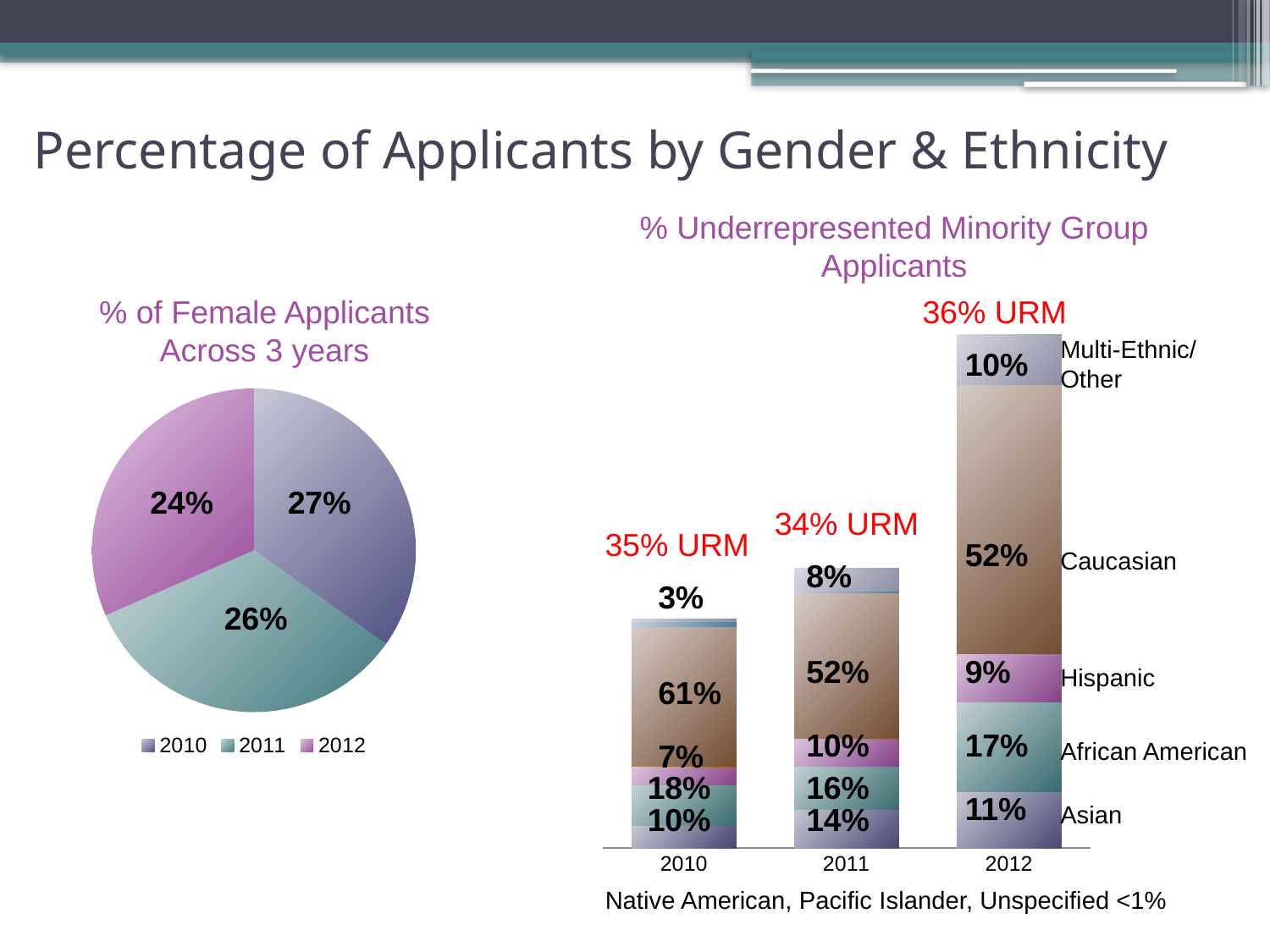
In the '% Underrepresented Minority Group Applicants' chart, what is the Asian percentage for 2011? 14% What kind of chart is the '% Underrepresented Minority Group Applicants' chart? stacked bar chart In the '% Underrepresented Minority Group Applicants' chart, what is the Caucasian percentage for 2010? 61% In the '% Underrepresented Minority Group Applicants' chart, how many years are shown on the x axis? 3 In the '% of Female Applicants Across 3 years' pie chart, which year has the smallest slice? 2012 In the '% Underrepresented Minority Group Applicants' chart, what is the Multi-Ethnic/Other percentage for 2012? 10% In the '% of Female Applicants Across 3 years' pie chart, what is the value for 2010? 27% What kind of chart is the '% of Female Applicants Across 3 years' chart? pie chart In the '% Underrepresented Minority Group Applicants' chart, which year has the highest African American percentage? 2010 In the '% Underrepresented Minority Group Applicants' chart, which is larger: the Hispanic percentage for 2011 or for 2012? 2011 In the '% Underrepresented Minority Group Applicants' chart, what is the difference between the Caucasian percentages for 2010 and 2011? 9% In the '% of Female Applicants Across 3 years' pie chart, how many years does the legend list? 3